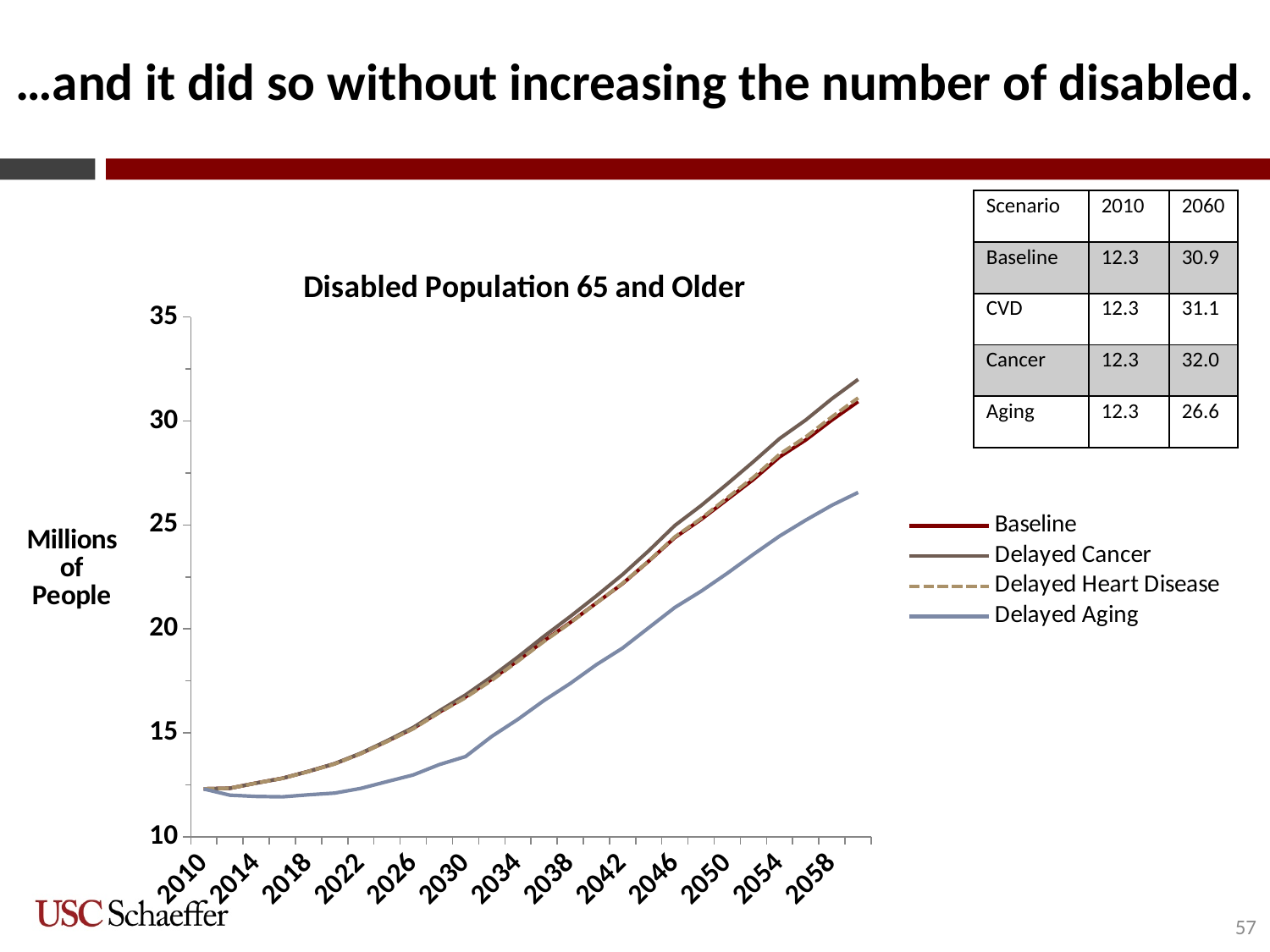
According to the table on the slide, what is the 2060 value for the Aging scenario? 26.6 How many series does the chart legend list? 4 What kind of chart is shown on the slide? line chart Is the value for Delayed Aging in 2058 greater or less than 25? greater According to the table on the slide, what is the difference between the 2060 values for the Baseline and Aging scenarios? 4.3 Do the values for the Baseline series rise or fall from 2010 to 2058? rise What is the title of the chart? Disabled Population 65 and Older What is the label on the vertical axis of the chart? Millions of People Is the value for Baseline in 2030 greater or less than 20? less Which series has the lowest value in 2058? Delayed Aging Is the value for Delayed Cancer in 2058 greater or less than 30? greater Which series has the highest value in 2058? Delayed Cancer